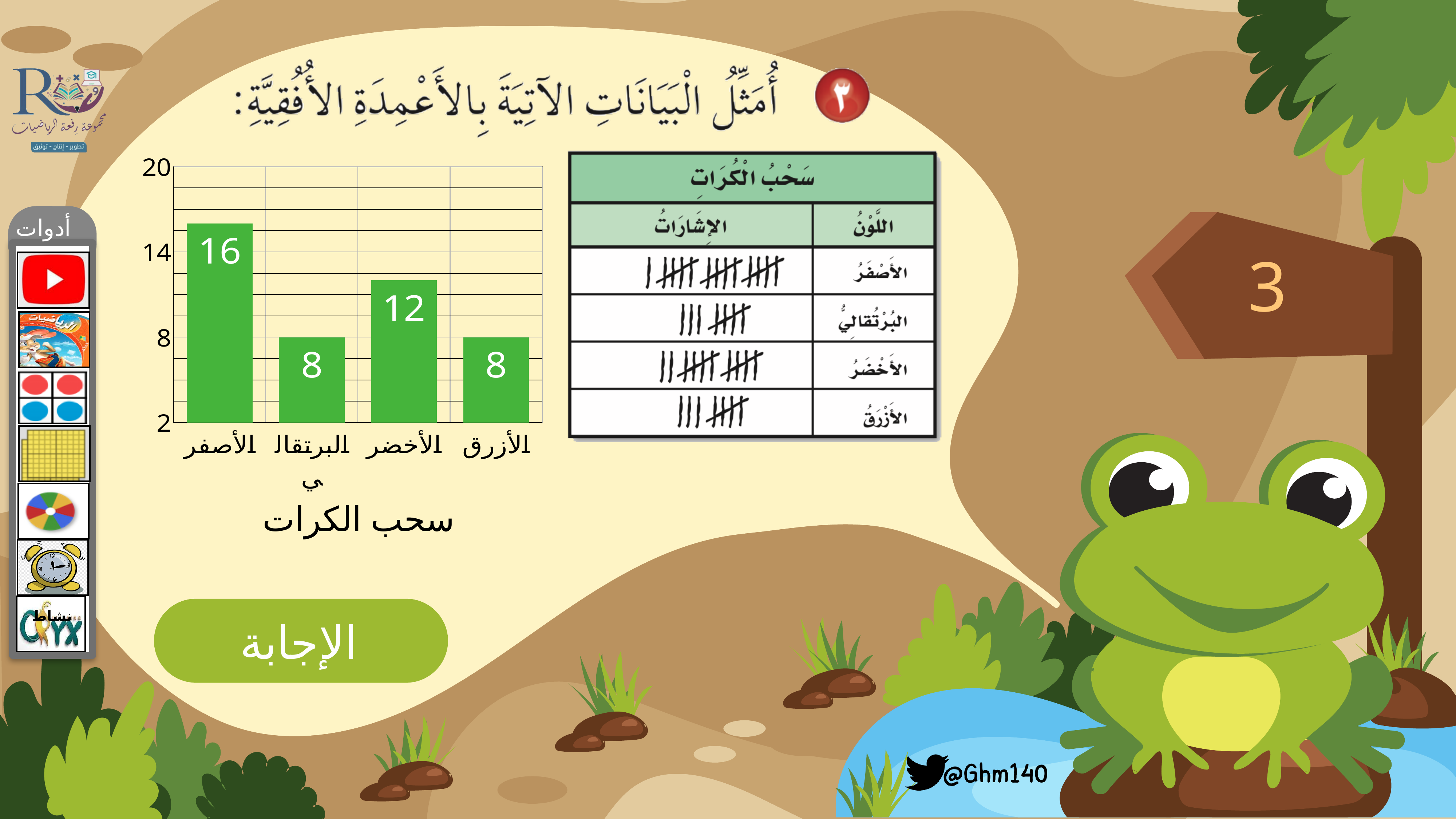
Which category has the highest bar in the chart? الأصفر Is the value for الأصفر greater or less than 14? greater What is the value of the bar for الأصفر (yellow) in the chart? 16 What is the difference between the values for الأصفر and الأخضر? 4 What is the value of the bar for الأخضر (green) in the chart? 12 What is the title written below the chart? سحب الكرات Which is larger, the value for الأخضر or the value for الأزرق? الأخضر What is the difference between the values for الأصفر and الأزرق? 8 What is the value of the bar for الأزرق (blue) in the chart? 8 What kind of chart is shown on the slide? bar chart What is the value of the bar for البرتقالي (orange) in the chart? 8 How many categories are shown on the x axis of the chart? 4